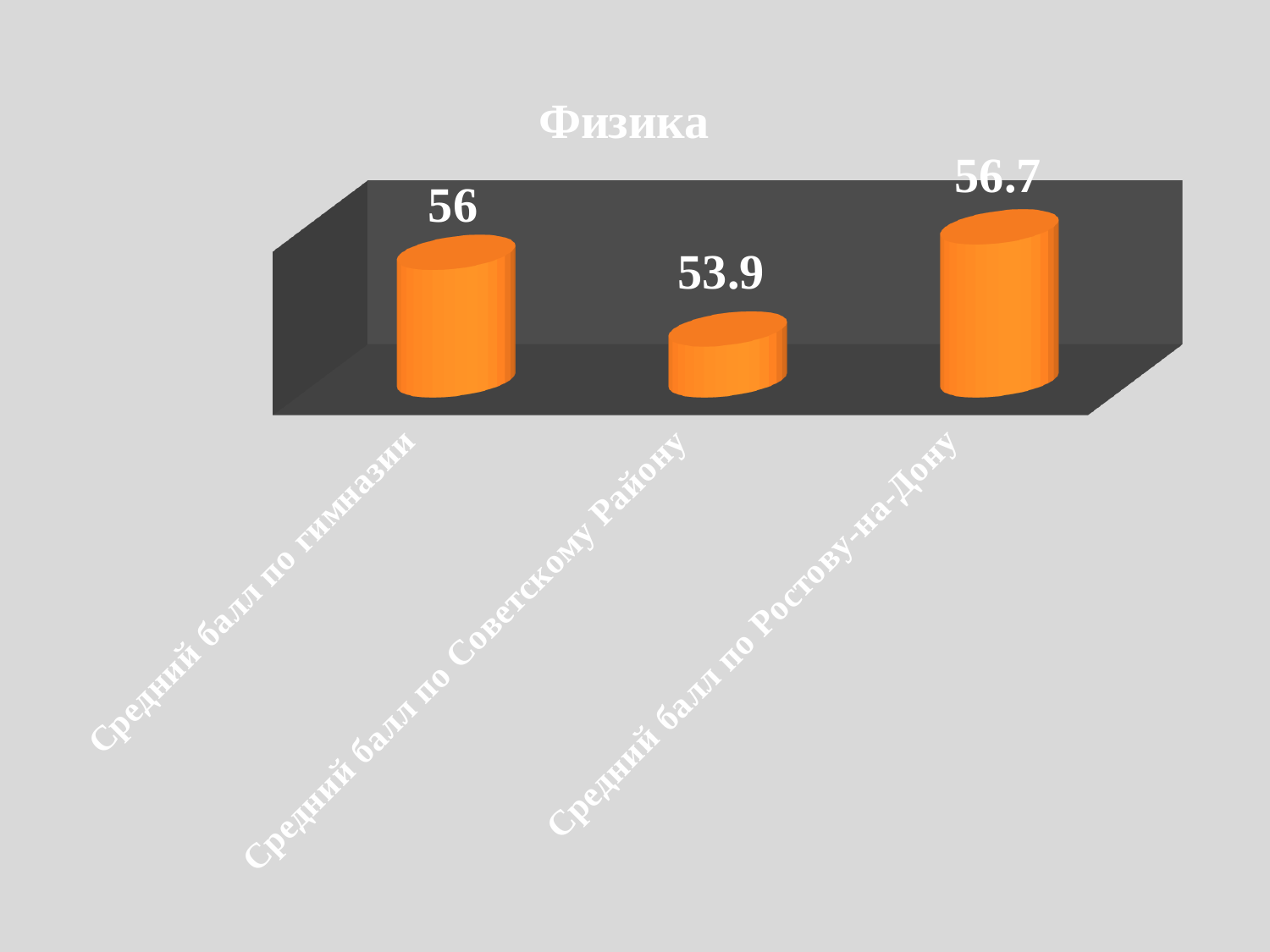
What is the value for Средний балл по Ростову-на-Дону? 56.7 What colour are the bars in the chart? orange What is the difference between the values for Средний балл по Ростову-на-Дону and Средний балл по гимназии? 0.7 What is the difference between the values for Средний балл по гимназии and Средний балл по Советскому Району? 2.1 What is the value for Средний балл по Советскому Району? 53.9 Which category has the lowest value? Средний балл по Советскому Району What is the value for Средний балл по гимназии? 56 Which is larger: the value for Средний балл по гимназии or the value for Средний балл по Советскому Району? Средний балл по гимназии How many categories are shown in the chart? 3 Which category has the highest value? Средний балл по Ростову-на-Дону What is the title of the chart? Физика What kind of chart is this? bar chart